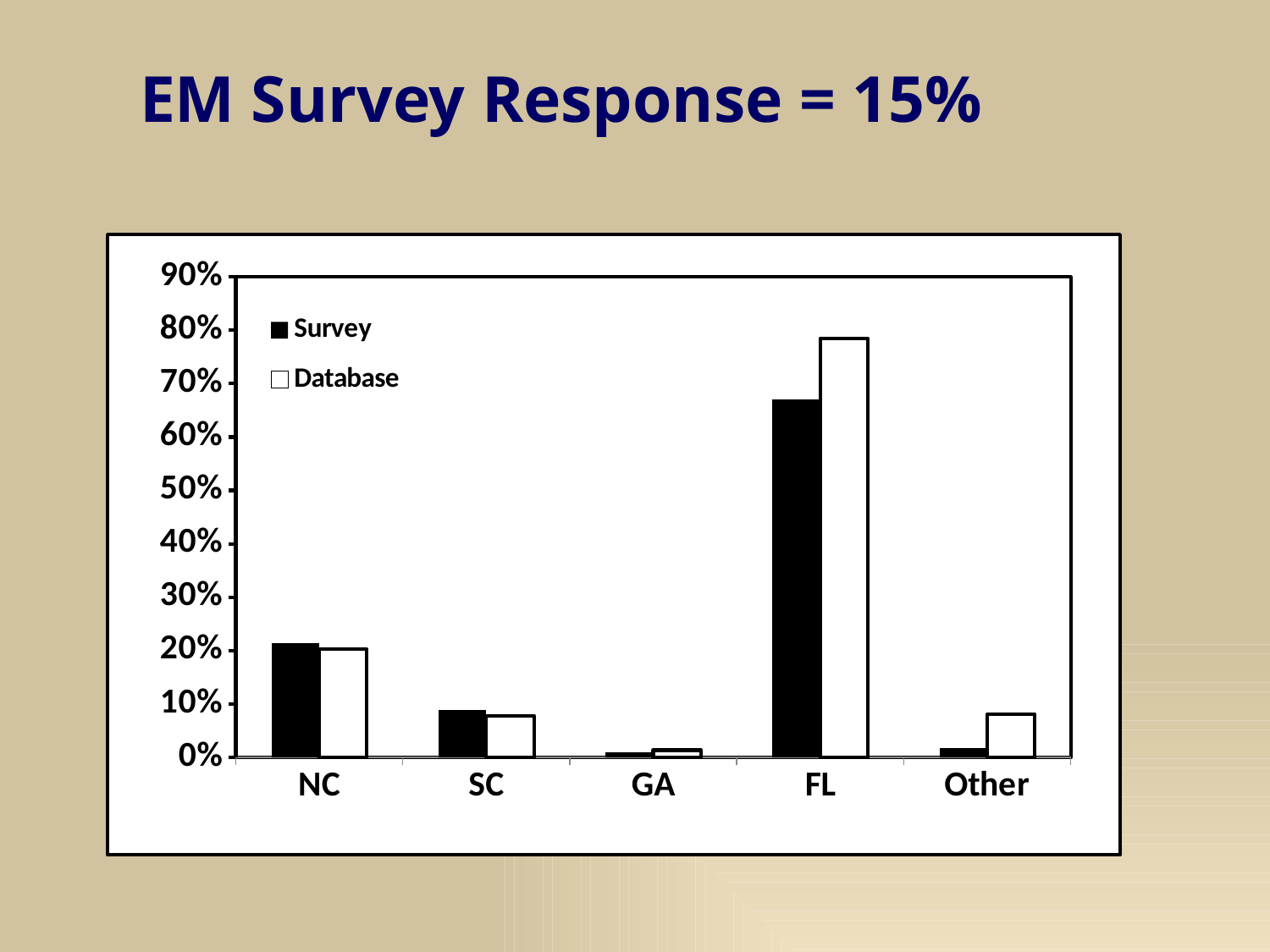
Which series is shown with black bars in the chart? Survey What kind of chart is shown on the slide? bar chart Which category has the lowest Database value? GA Is the Survey value for FL greater or less than 60%? greater How many categories are shown on the x axis of the chart? 5 How many series does the chart's legend list? 2 For FL, which is larger, the Survey value or the Database value? Database Which category has the highest Database value? FL For Other, which is larger, the Survey value or the Database value? Database Which category has the highest Survey value? FL Is the Database value for FL greater or less than 70%? greater Is the Survey value for NC greater or less than 30%? less